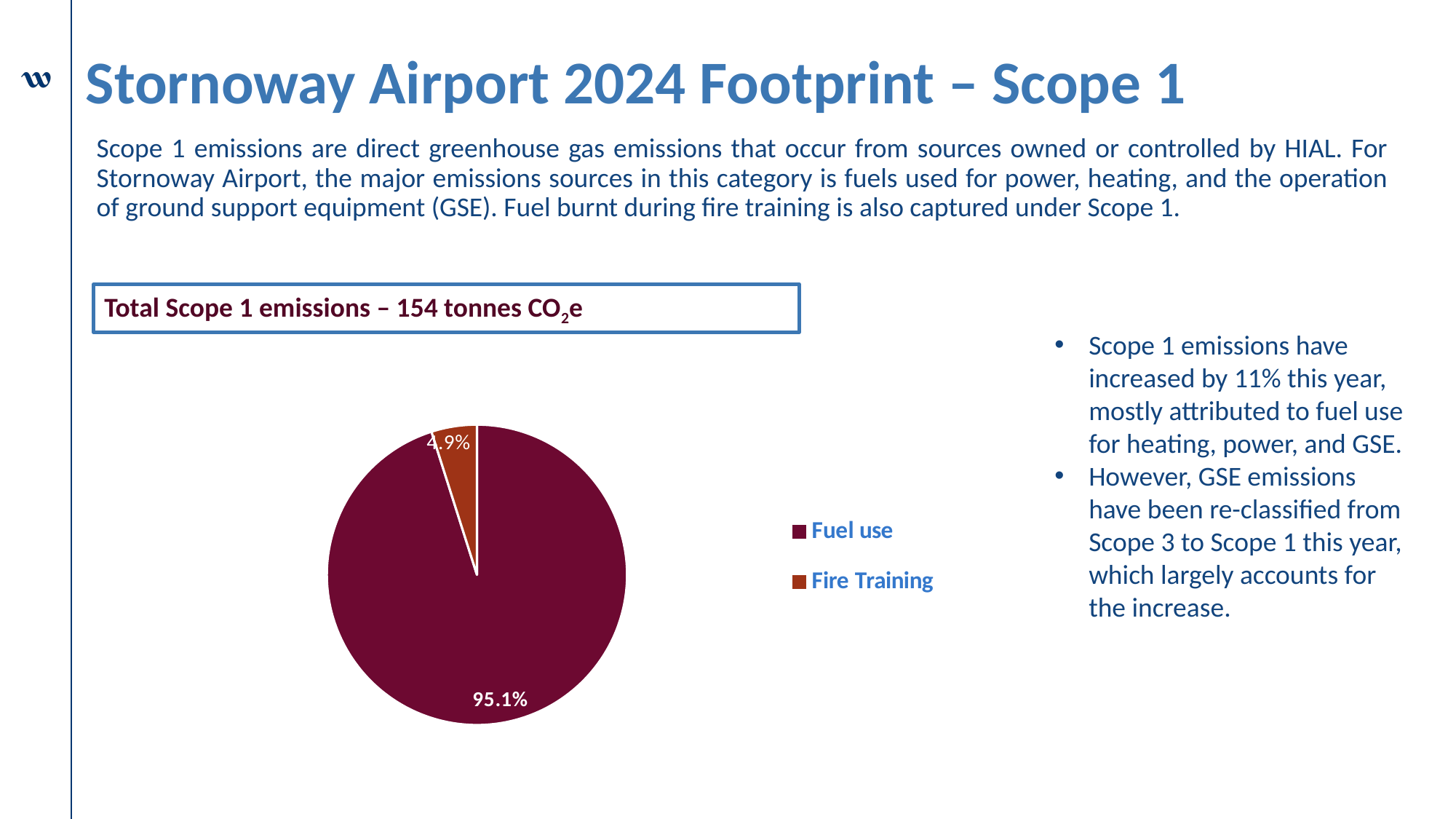
How many entries does the legend list? 2 What colour is the Fire Training slice in the pie chart? Orange-brown Which category has the smallest slice of the pie? Fire Training Is the share for Fire Training greater or less than 10%? less What kind of chart is shown on the slide? Pie chart What is the difference in percentage points between the Fuel use and Fire Training slices? 90.2 What total Scope 1 emissions figure is stated in the box above the chart? 154 tonnes CO2e How many categories does the pie chart show? 2 Which category has the largest slice of the pie? Fuel use What share of the pie does Fire Training account for? 4.9% Which is larger, the Fuel use slice or the Fire Training slice? Fuel use What share of the pie does Fuel use account for? 95.1%